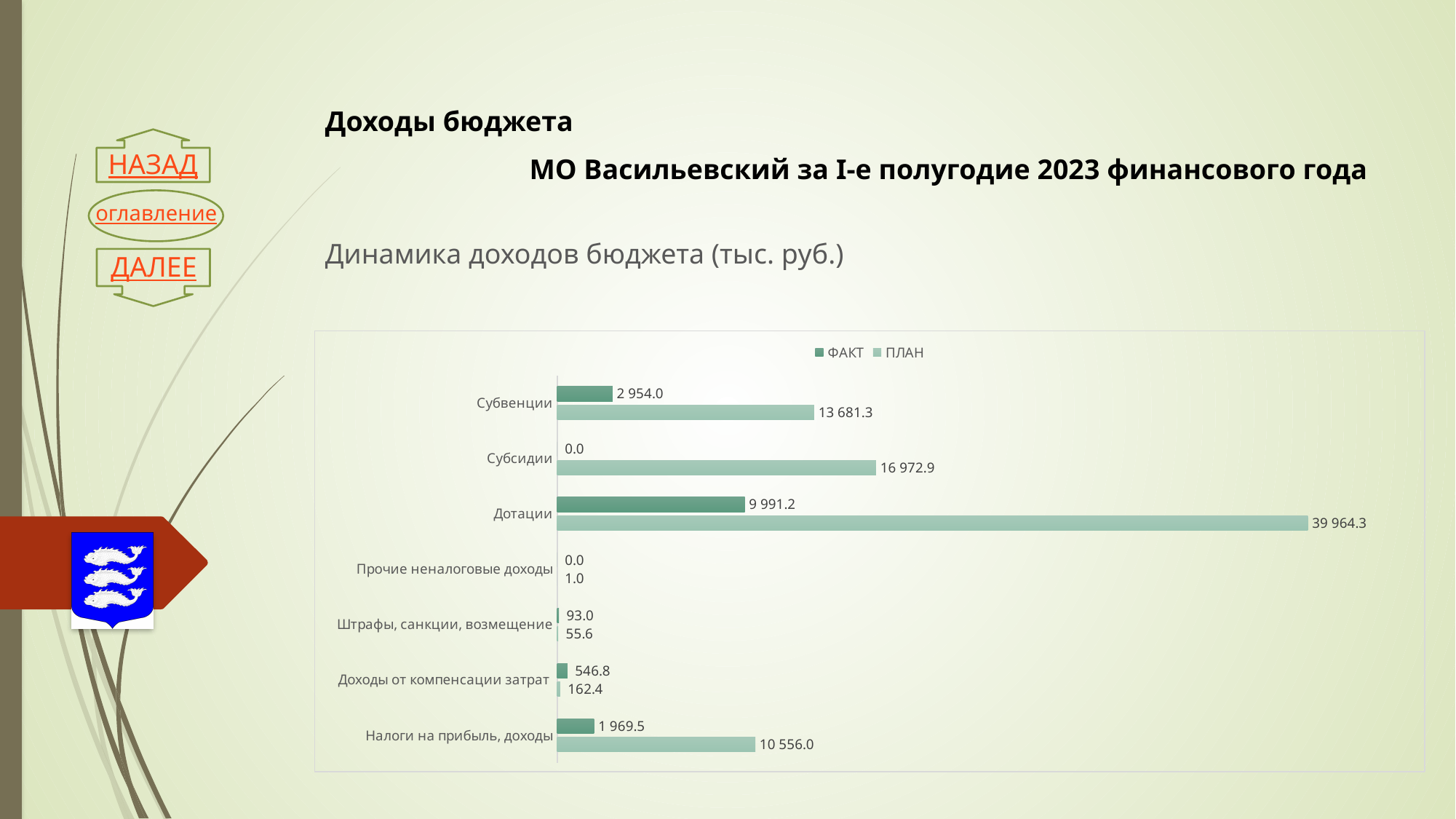
What is the ФАКТ value for Штрафы, санкции, возмещение? 93.0 How many categories are shown on the chart? 7 How many series does the legend list? 2 Which category has the highest ПЛАН value? Дотации What is the ПЛАН value for Субсидии? 16 972.9 Which is larger for Доходы от компенсации затрат: the ФАКТ value or the ПЛАН value? ФАКТ What is the difference between the ПЛАН and ФАКТ values for Субвенции? 10 727.3 What is the ФАКТ value for Дотации? 9 991.2 What kind of chart is shown on the slide? Bar chart What is the ПЛАН value for Налоги на прибыль, доходы? 10 556.0 What is the difference between the ПЛАН and ФАКТ values for Дотации? 29 973.1 Which category has the lowest ПЛАН value? Прочие неналоговые доходы